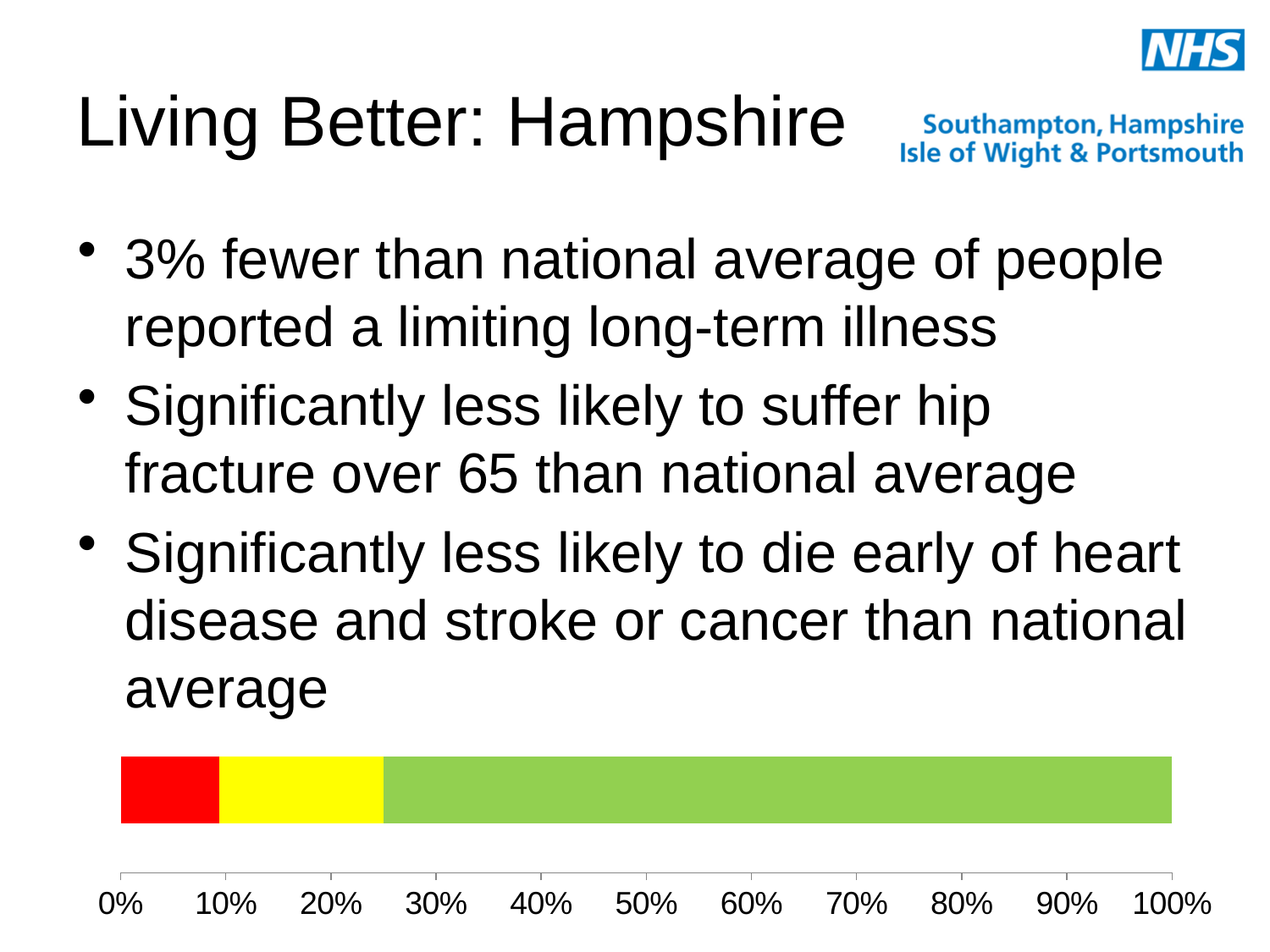
Is the green segment of the bar greater or less than 60%? greater What are the three colours of the bar segments, from left to right? red, yellow, green How many coloured segments make up the bar in the chart? 3 What kind of chart is shown at the bottom of the slide? bar chart Which coloured segment of the bar is the largest? green Is the yellow segment of the bar greater or less than 20%? less Which segment is larger, the green segment or the yellow segment? green What is the highest value shown on the chart's x axis? 100% Is the red segment of the bar greater or less than 20%? less Which coloured segment of the bar is the smallest? red